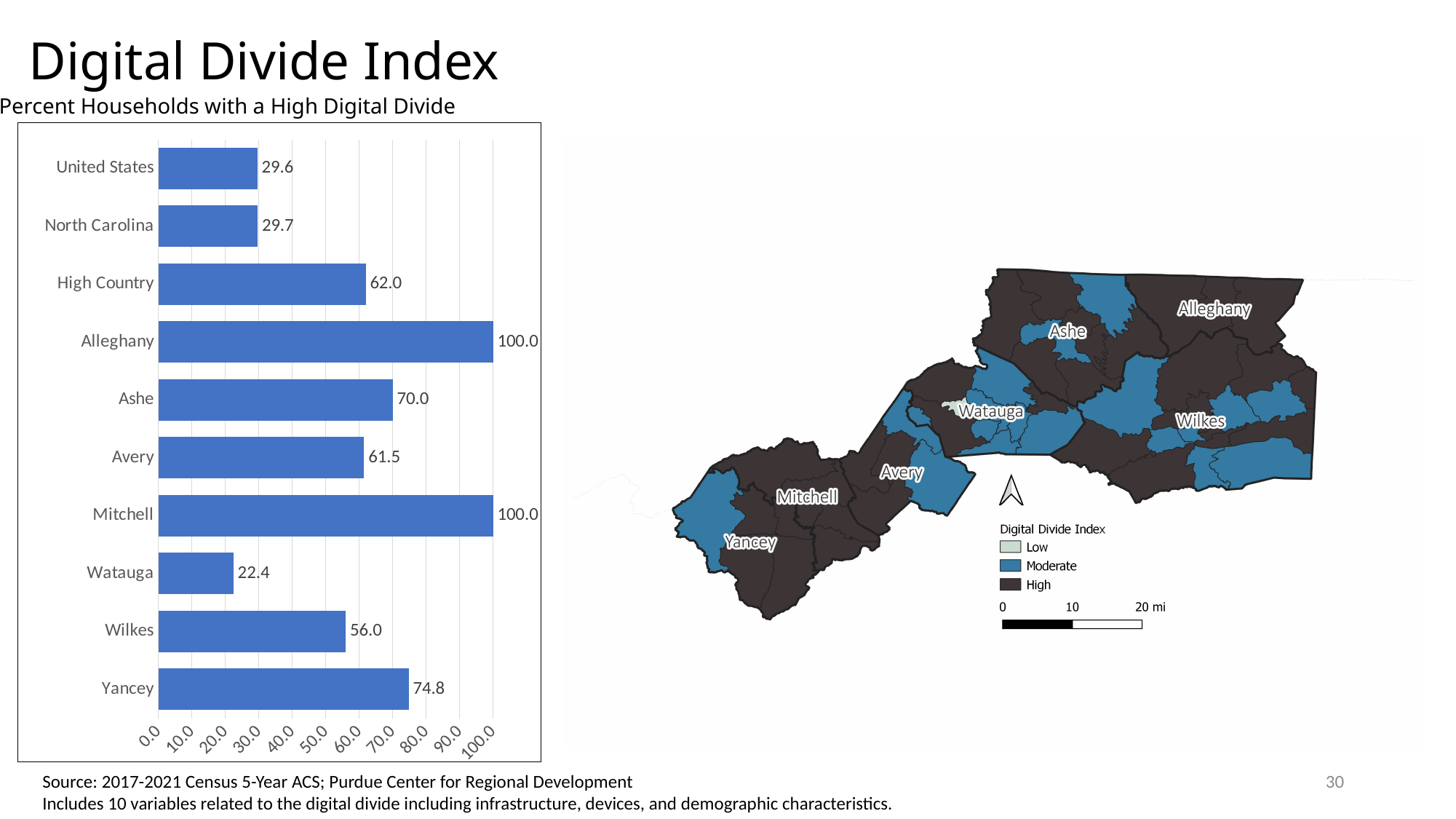
What is the value for Yancey in the bar chart? 74.8 What is the value for North Carolina in the bar chart? 29.7 How many categories are shown in the bar chart? 10 Which two categories share the highest value of 100.0 in the bar chart? Alleghany and Mitchell What is the title of the chart on the slide? Percent Households with a High Digital Divide What is the value for High Country in the bar chart? 62.0 What kind of chart is used to show Percent Households with a High Digital Divide? Bar chart What is the value for Watauga in the bar chart? 22.4 Which category has the lowest value in the bar chart? Watauga What is the difference between the values for Ashe and Wilkes in the bar chart? 14.0 What is the difference between the values for Yancey and the United States in the bar chart? 45.2 Which is larger in the bar chart, the value for Avery or the value for Wilkes? Avery